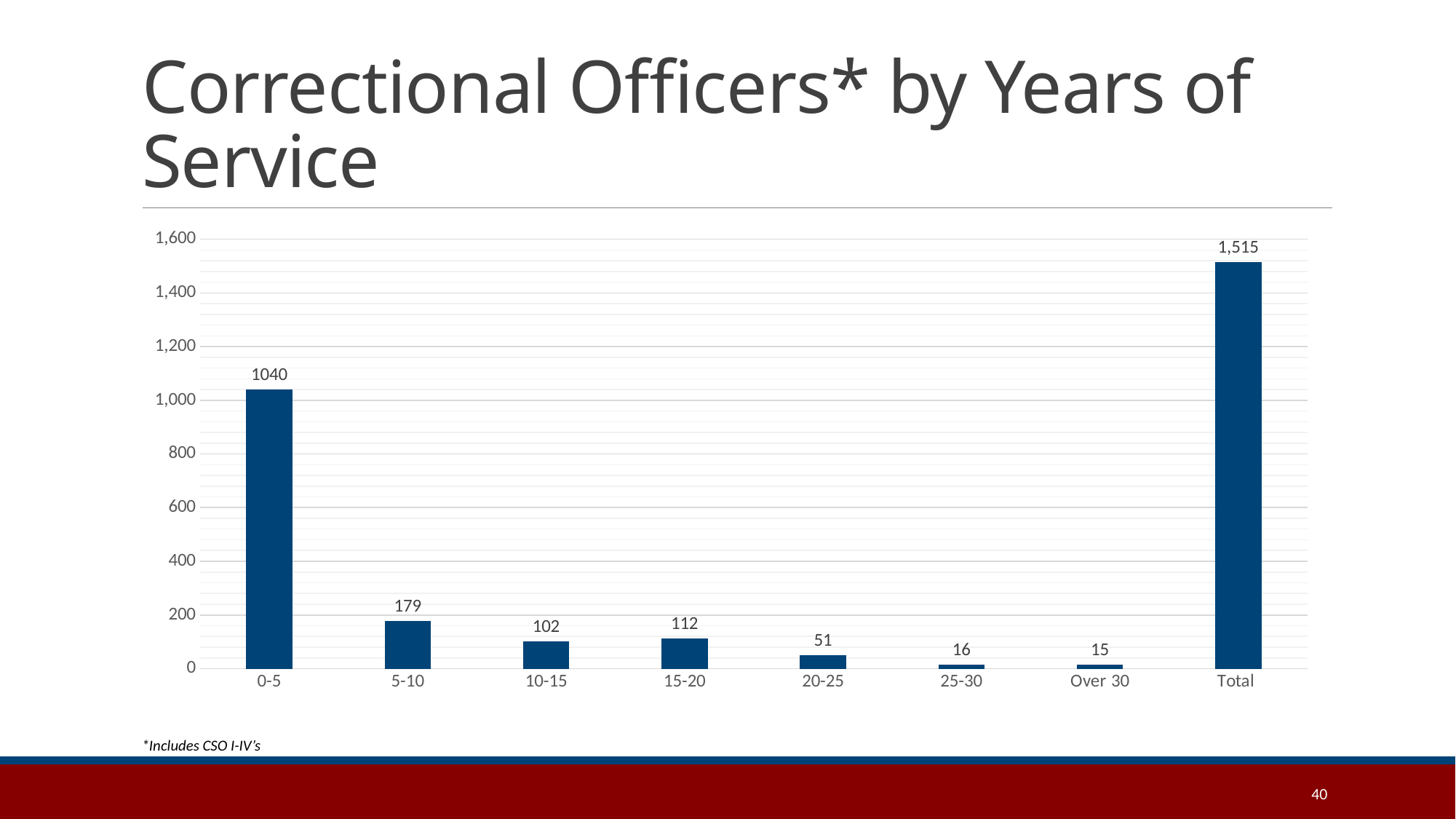
How many bars are shown in the chart? 8 Which years-of-service category has the lowest value? Over 30 What is the value shown for the 5-10 years of service category? 179 How many correctional officers have 0-5 years of service? 1040 Which is larger, the value for 10-15 years or the value for 15-20 years of service? 15-20 Is the value for 20-25 years of service greater or less than 200? less What is the title of the slide? Correctional Officers* by Years of Service What is the value shown for the Total bar? 1,515 What kind of chart is shown on the slide? bar chart How many correctional officers have over 30 years of service? 15 What is the difference between the values for 0-5 and 5-10 years of service? 861 Excluding the Total bar, which years-of-service category has the highest value? 0-5